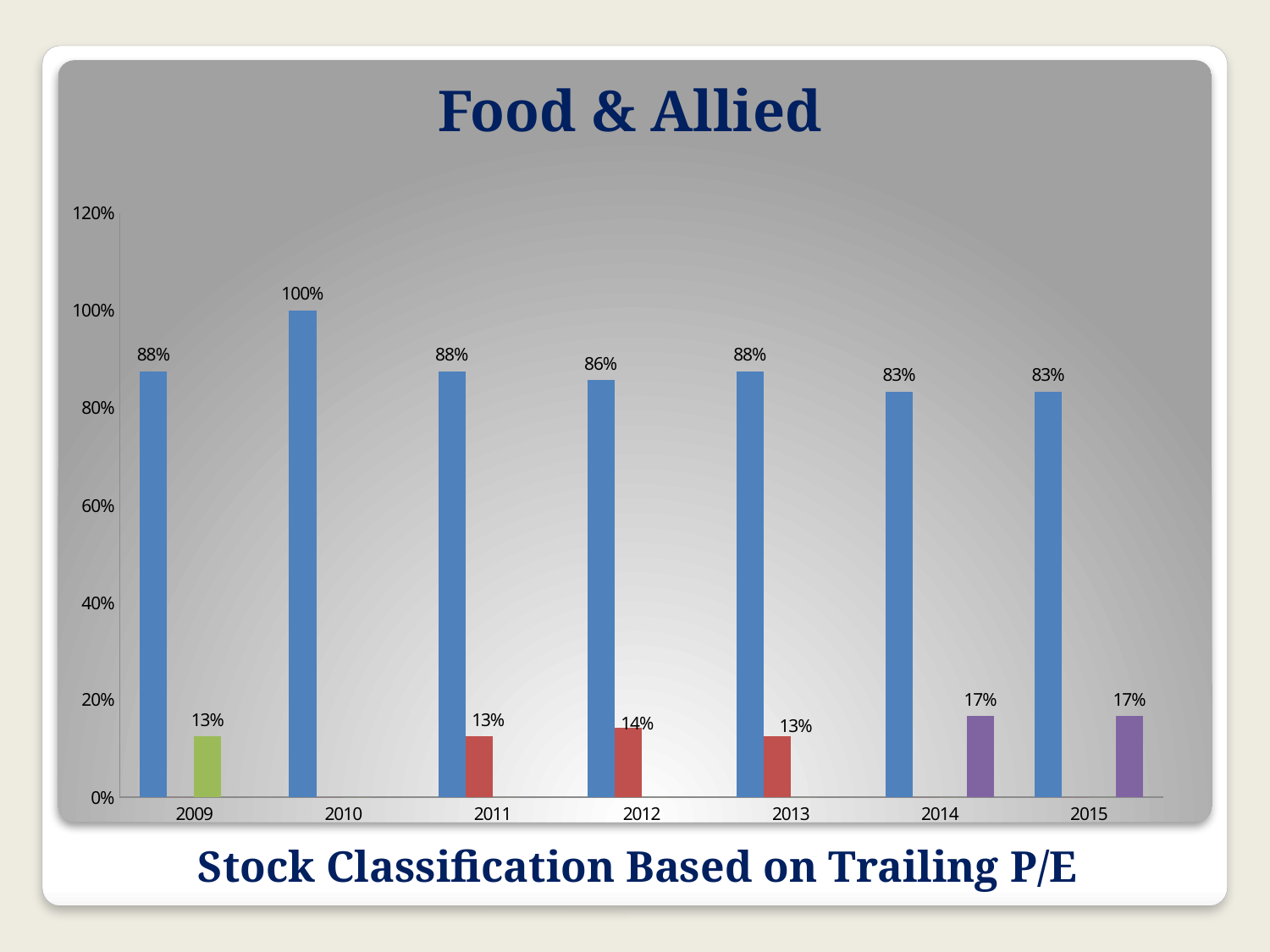
Which is larger, the blue bar for 2011 or the blue bar for 2012? 2011 In which year is the blue bar highest? 2010 What kind of chart is shown on the slide? bar chart What is the value of the red bar for 2012? 14% What is the value of the purple bar for 2015? 17% What is the value of the blue bar for 2012? 86% What is the value of the green bar for 2009? 13% What is the difference between the blue bar and the red bar for 2013? 75% How many years are shown on the x axis? 7 What is the title of the chart? Food & Allied What is the value of the blue bar for 2010? 100% What is the difference between the blue bar values for 2010 and 2014? 17%